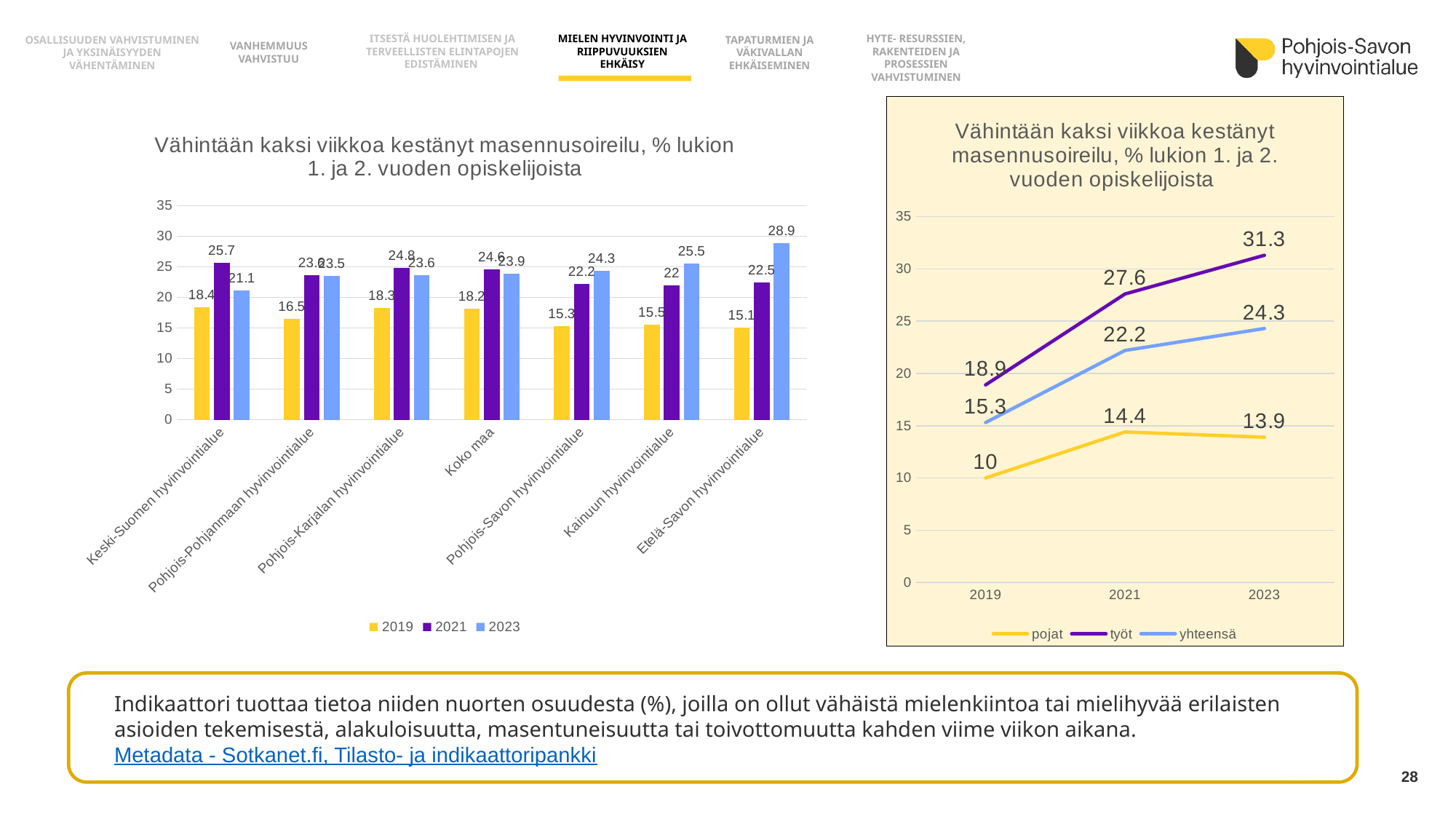
In the line chart on the right, what is the difference between työt and pojat in 2021? 13.2 In the bar chart on the left, what is the difference between the 2021 and 2019 values for Keski-Suomen hyvinvointialue? 7.3 In the line chart on the right, does the yhteensä line rise or fall from 2019 to 2023? rise In the bar chart on the left, what is the 2019 value for Pohjois-Savon hyvinvointialue? 15.3 In the line chart on the right, what is the value for työt in 2023? 31.3 What kind of chart is shown on the right side of the slide? line chart In the bar chart on the left, how many categories are shown on the x axis? 7 In the bar chart on the left, which category has the highest 2023 value? Etelä-Savon hyvinvointialue In the line chart on the right, what is the value for pojat in 2019? 10 In the bar chart on the left, what is the 2023 value for Etelä-Savon hyvinvointialue? 28.9 In the bar chart on the left, which category has the lowest 2019 value? Etelä-Savon hyvinvointialue In the bar chart on the left, how many series does the legend list? 3